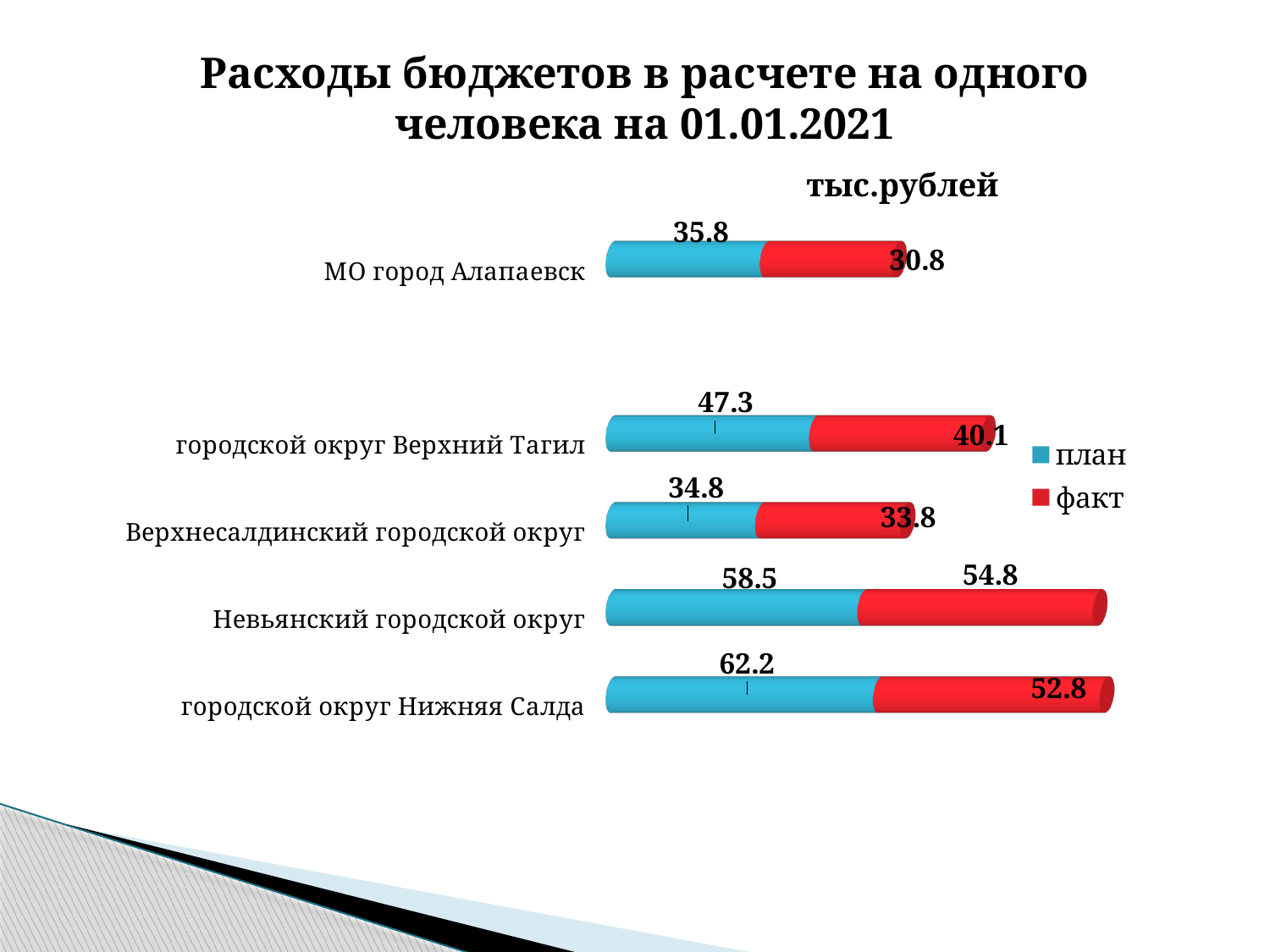
How many series does the legend list? 2 Which category has the highest план value? городской округ Нижняя Салда What unit is stated above the chart? тыс.рублей What is the total of the stacked bar for Верхнесалдинский городской округ? 68.6 Which is larger: the факт value for Невьянский городской округ or the факт value for Верхнесалдинский городской округ? Невьянский городской округ What kind of chart is shown on the slide? bar chart What is the факт value for городской округ Верхний Тагил? 40.1 How many categories are shown in the chart? 5 Which category has the lowest факт value? МО город Алапаевск What is the факт value for МО город Алапаевск? 30.8 What is the план value for Невьянский городской округ? 58.5 What is the difference between the план and факт values for городской округ Нижняя Салда? 9.4